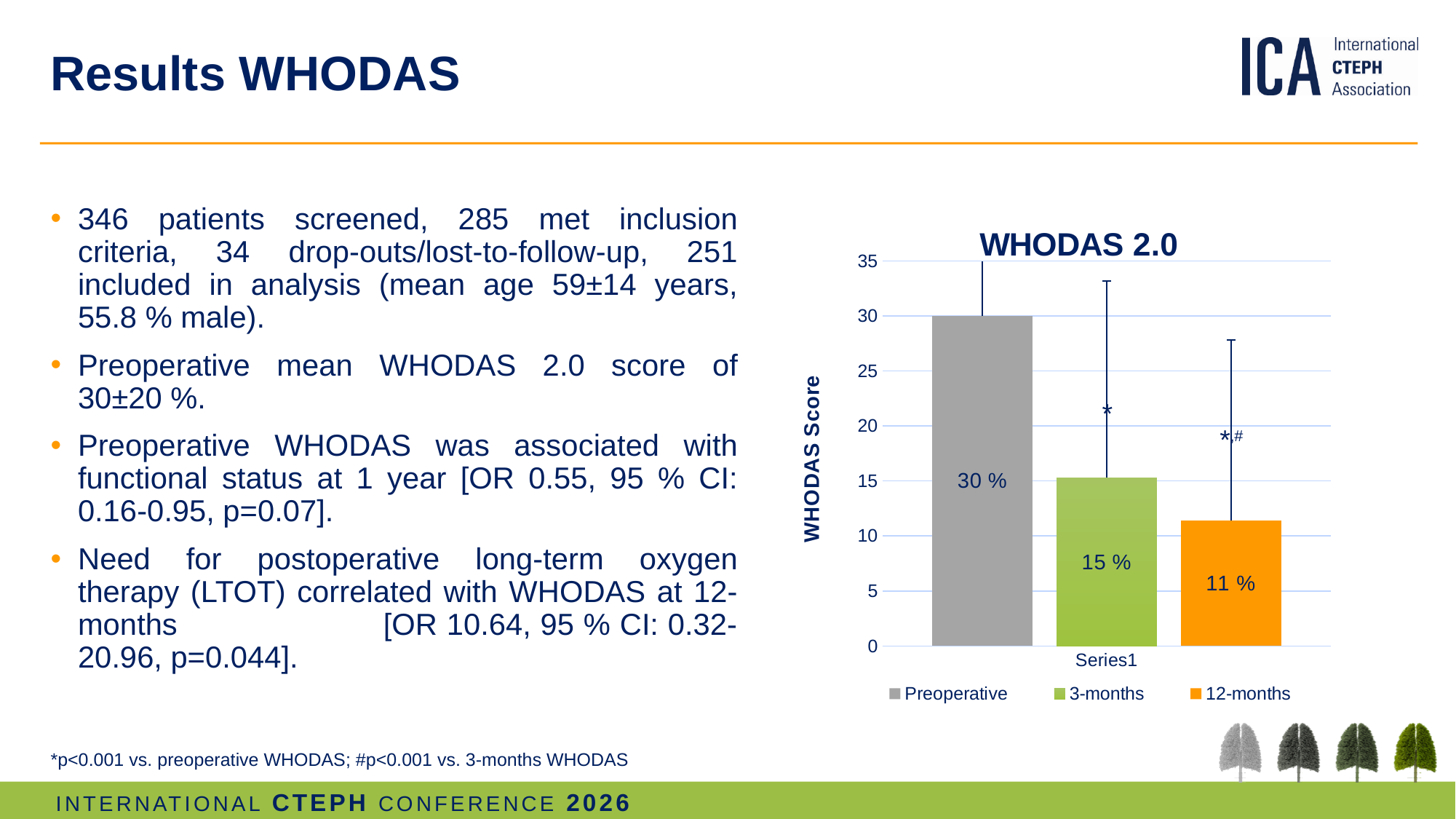
Which series has the lowest value in the WHODAS 2.0 chart? 12-months What is the value of the Preoperative bar in the WHODAS 2.0 chart? 30 % How many series does the legend of the WHODAS 2.0 chart list? 3 What is the difference between the Preoperative and 3-months values in the WHODAS 2.0 chart? 15 % What is the value of the 3-months bar in the WHODAS 2.0 chart? 15 % What is the difference between the 3-months and 12-months values in the WHODAS 2.0 chart? 4 % Which series has the highest value in the WHODAS 2.0 chart? Preoperative What kind of chart is the WHODAS 2.0 chart? Bar chart What is the label of the vertical axis in the WHODAS 2.0 chart? WHODAS Score Is the Preoperative value in the WHODAS 2.0 chart greater or less than 25? greater What is the value of the 12-months bar in the WHODAS 2.0 chart? 11 % Which is larger in the WHODAS 2.0 chart, the 3-months value or the 12-months value? 3-months